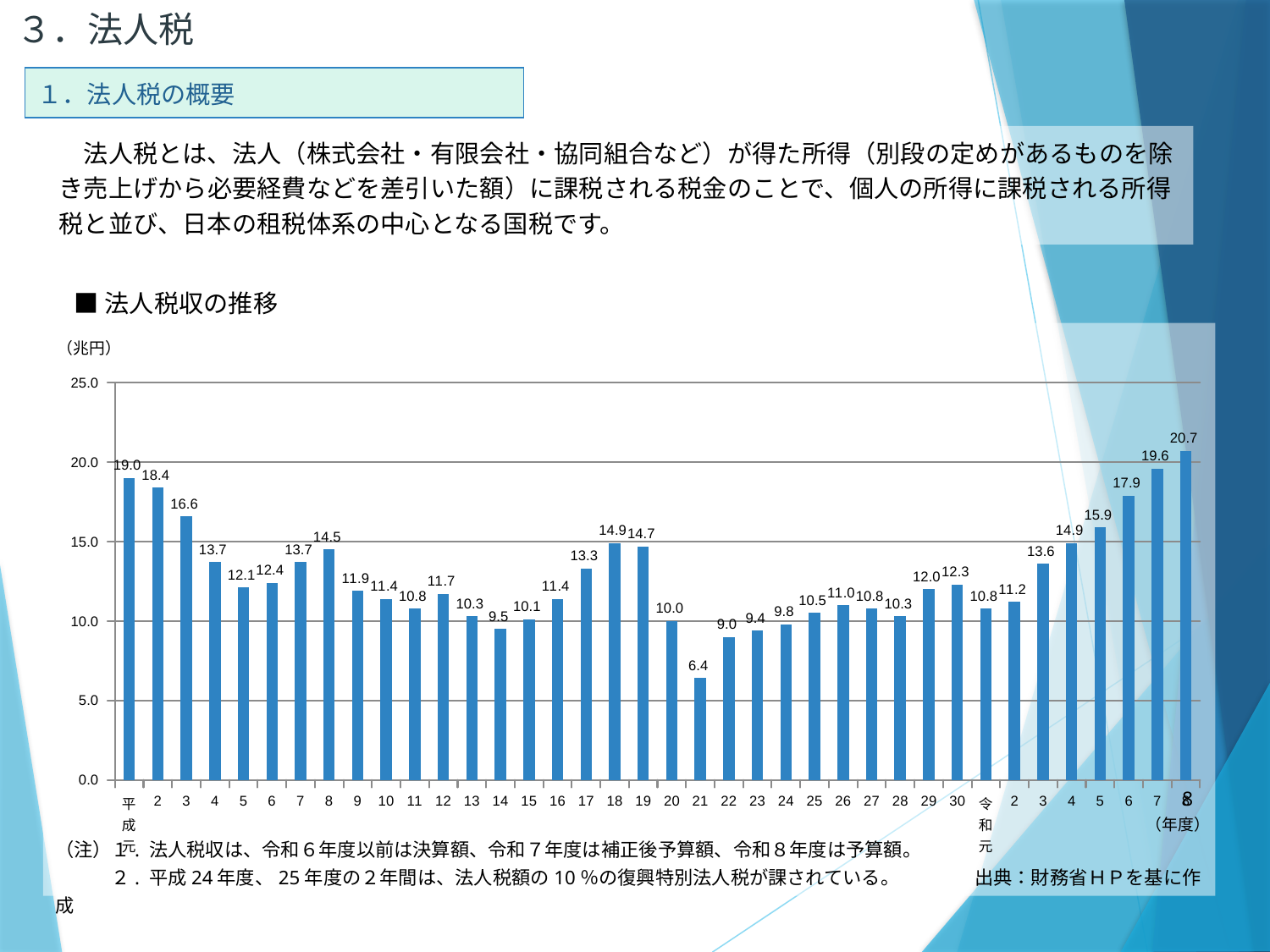
「法人税収の推移」のグラフで、法人税収が最も低い年度はどれですか。 平成21年度 「法人税収の推移」のグラフには、いくつの年度の棒がありますか。 38 「法人税収の推移」のグラフで、令和8年度と令和7年度の法人税収の差はいくらですか。 1.1 「法人税収の推移」のグラフで、平成元年度の法人税収はいくらですか。 19.0 「法人税収の推移」のグラフで、令和元年度から令和8年度にかけて法人税収は増加していますか、減少していますか。 増加 「法人税収の推移」のグラフで、平成21年度の法人税収はいくらですか。 6.4 「法人税収の推移」のグラフの縦軸の単位は何ですか。 兆円 「法人税収の推移」のグラフはどの種類のグラフですか。 棒グラフ 「法人税収の推移」のグラフで、平成18年度と平成19年度では、どちらの法人税収が大きいですか。 平成18年度 「法人税収の推移」のグラフで、法人税収が最も高い年度はどれですか。 令和8年度 「法人税収の推移」のグラフで、平成3年度の法人税収は15.0より大きいですか、小さいですか。 大きい 「法人税収の推移」のグラフで、令和8年度の法人税収はいくらですか。 20.7